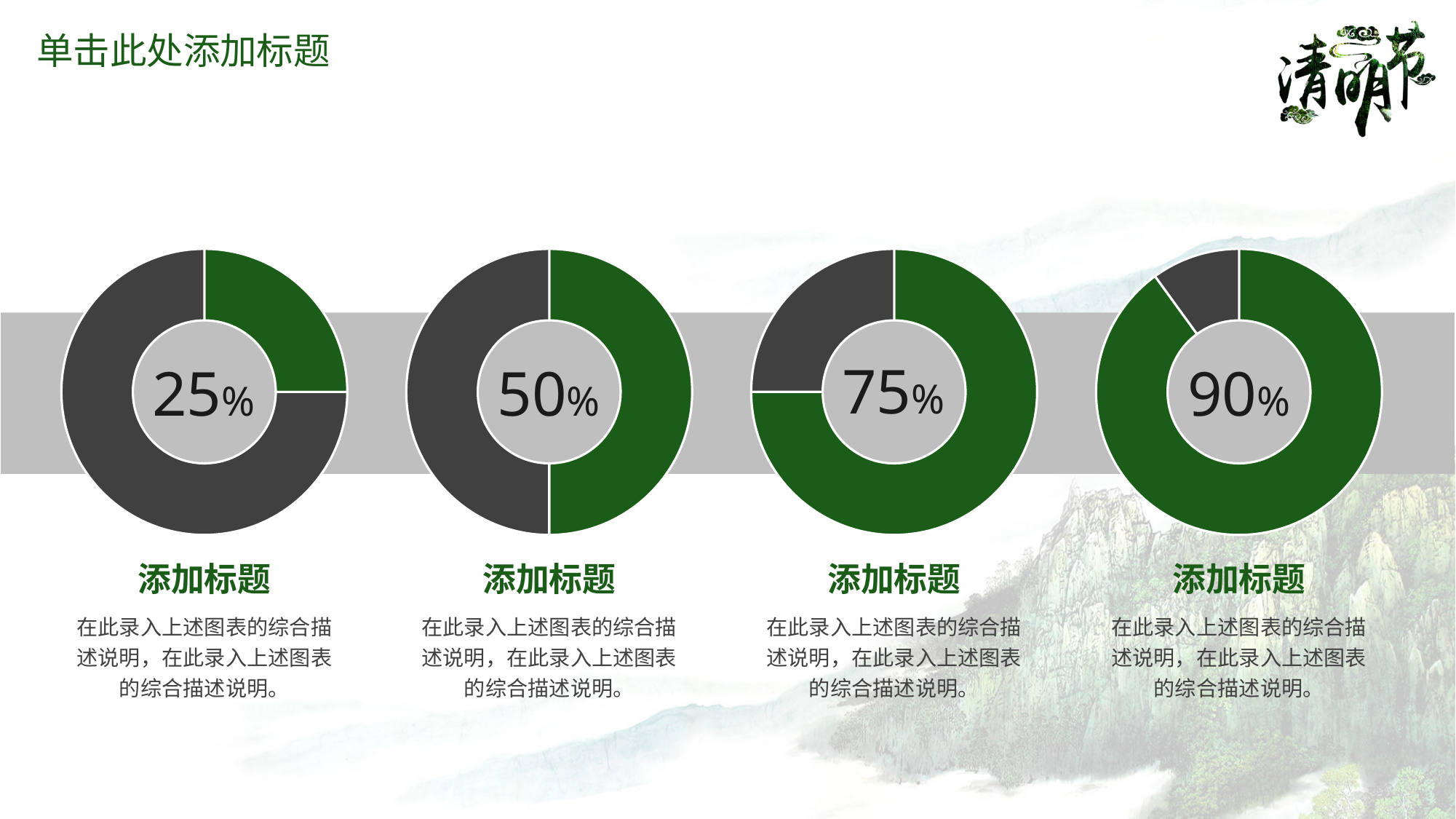
What is the difference between the percentages shown in the third and second donut charts from the left? 25% How many donut charts are on the slide? 4 What percentage is shown in the centre of the second donut chart from the left? 50% What kind of chart is used for each of the four figures on the slide? Donut chart Which donut chart on the slide shows the lowest percentage? The leftmost chart (25%) What percentage is shown in the centre of the third donut chart from the left? 75% Which donut chart on the slide shows the highest percentage? The rightmost chart (90%) What is the difference between the percentage in the rightmost donut chart and the percentage in the leftmost donut chart? 65% Which shows a larger percentage: the second donut chart from the left or the third donut chart from the left? The third donut chart from the left (75%) What percentage is shown in the centre of the rightmost donut chart? 90% Do the percentages shown in the donut charts increase or decrease from left to right across the slide? Increase What percentage is shown in the centre of the leftmost donut chart? 25%